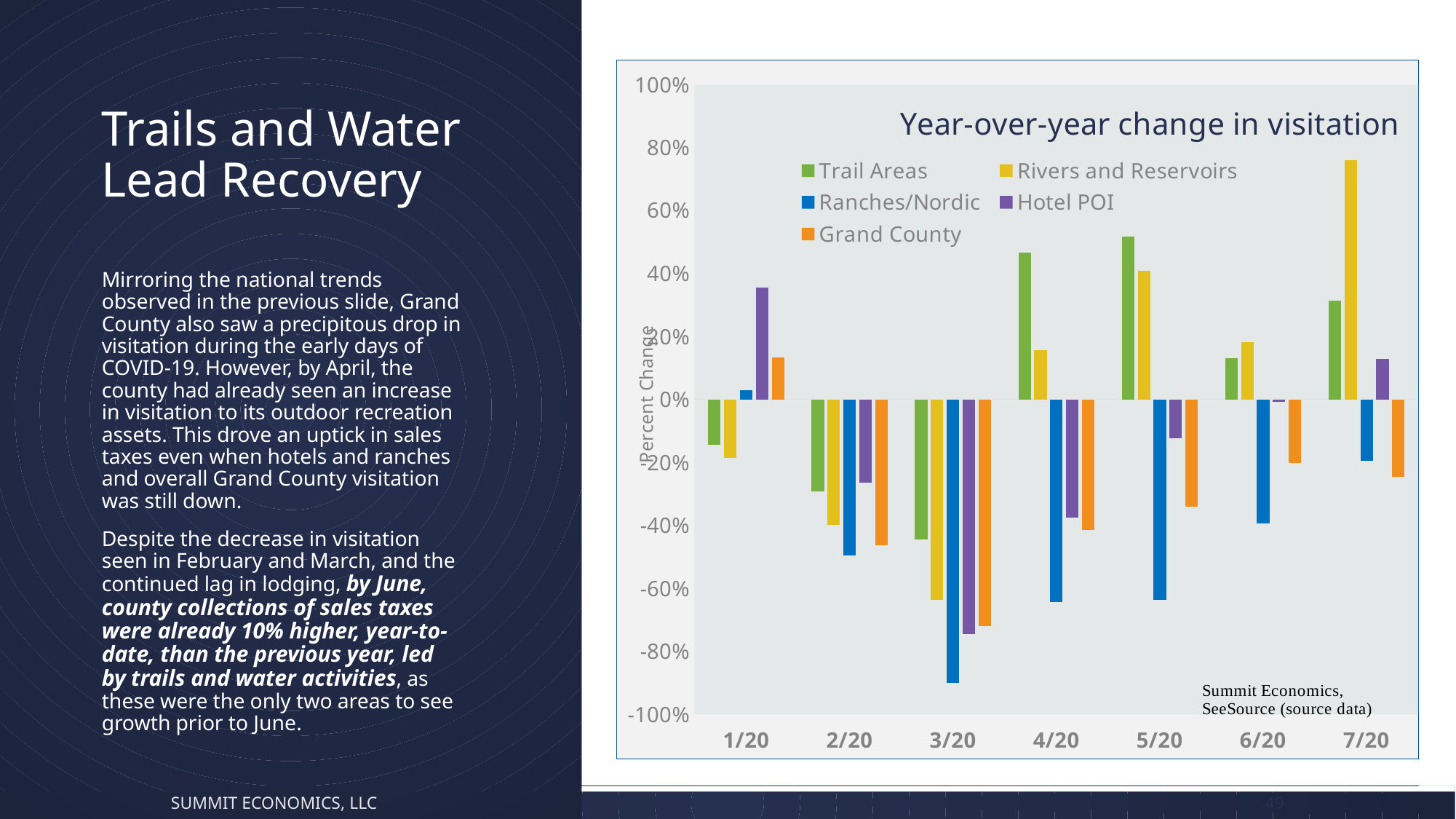
Is the Hotel POI value for 1/20 greater or less than 20%? greater What kind of chart is shown on the slide? bar chart In which month does Ranches/Nordic reach its lowest value? 3/20 Is the Grand County value for 3/20 greater or less than -60%? less In which month does Rivers and Reservoirs reach its highest value? 7/20 Do the Ranches/Nordic values rise or fall from 3/20 to 7/20? rise In 7/20, which is larger: Rivers and Reservoirs or Trail Areas? Rivers and Reservoirs Is the Ranches/Nordic value for 3/20 greater or less than -80%? less What is the title of the chart? Year-over-year change in visitation How many series does the legend of the 'Year-over-year change in visitation' chart list? 5 In 4/20, which is larger: Trail Areas or Rivers and Reservoirs? Trail Areas How many months are shown on the x axis of the chart? 7